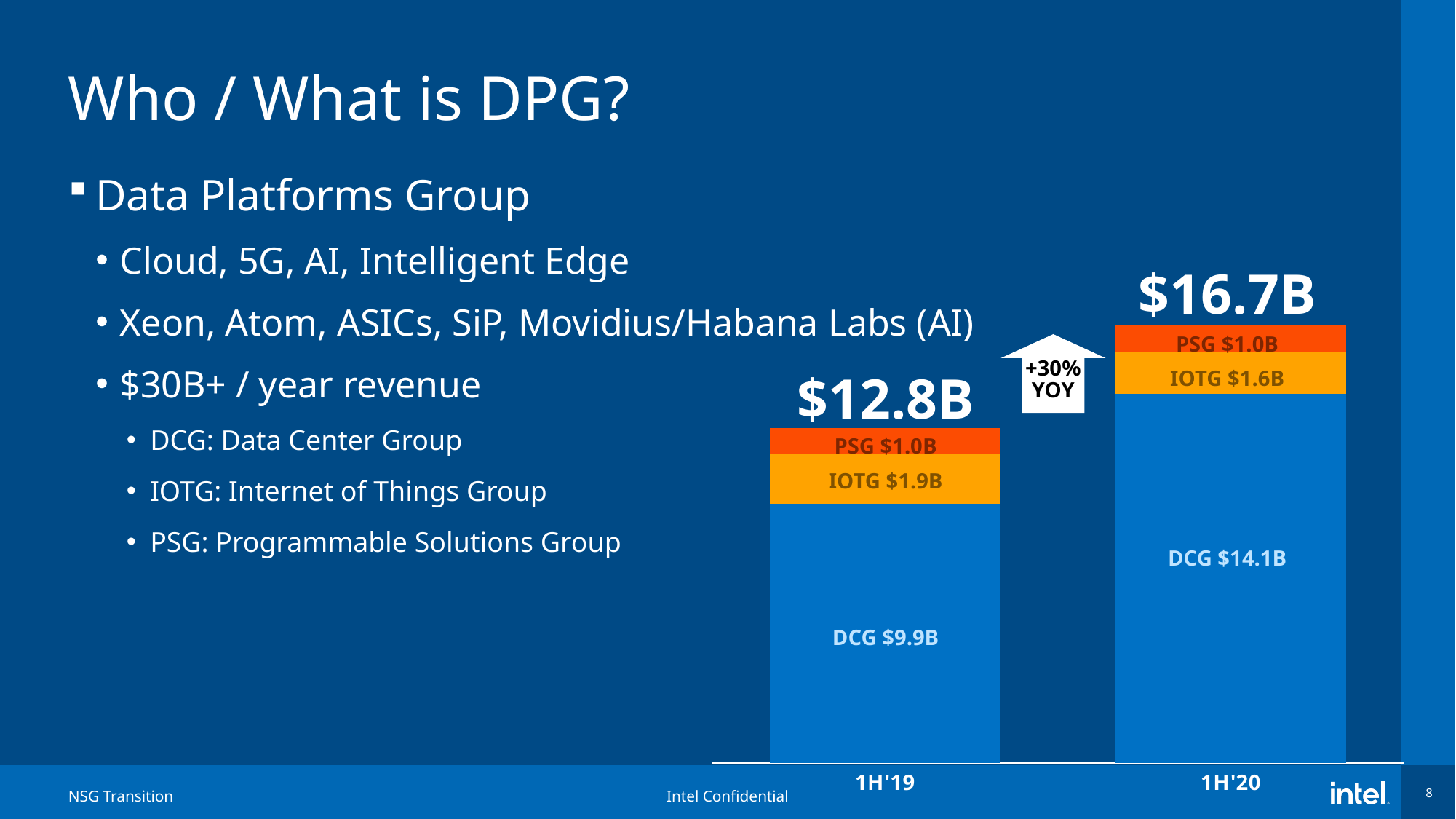
What kind of chart is shown on the slide? Stacked bar chart What is the total of the stacked bar for 1H'20? $16.7B What year-over-year growth percentage is shown between the two bars? +30% How many periods (categories) are shown on the x axis? 2 What is the IOTG value for 1H'20? $1.6B What is the DCG value for 1H'19? $9.9B What is the PSG value for 1H'20? $1.0B What is the IOTG value for 1H'19? $1.9B What is the total of the stacked bar for 1H'19? $12.8B Which period has the larger IOTG value, 1H'19 or 1H'20? 1H'19 What is the difference between the DCG values for 1H'20 and 1H'19? $4.2B What is the DCG value for 1H'20? $14.1B